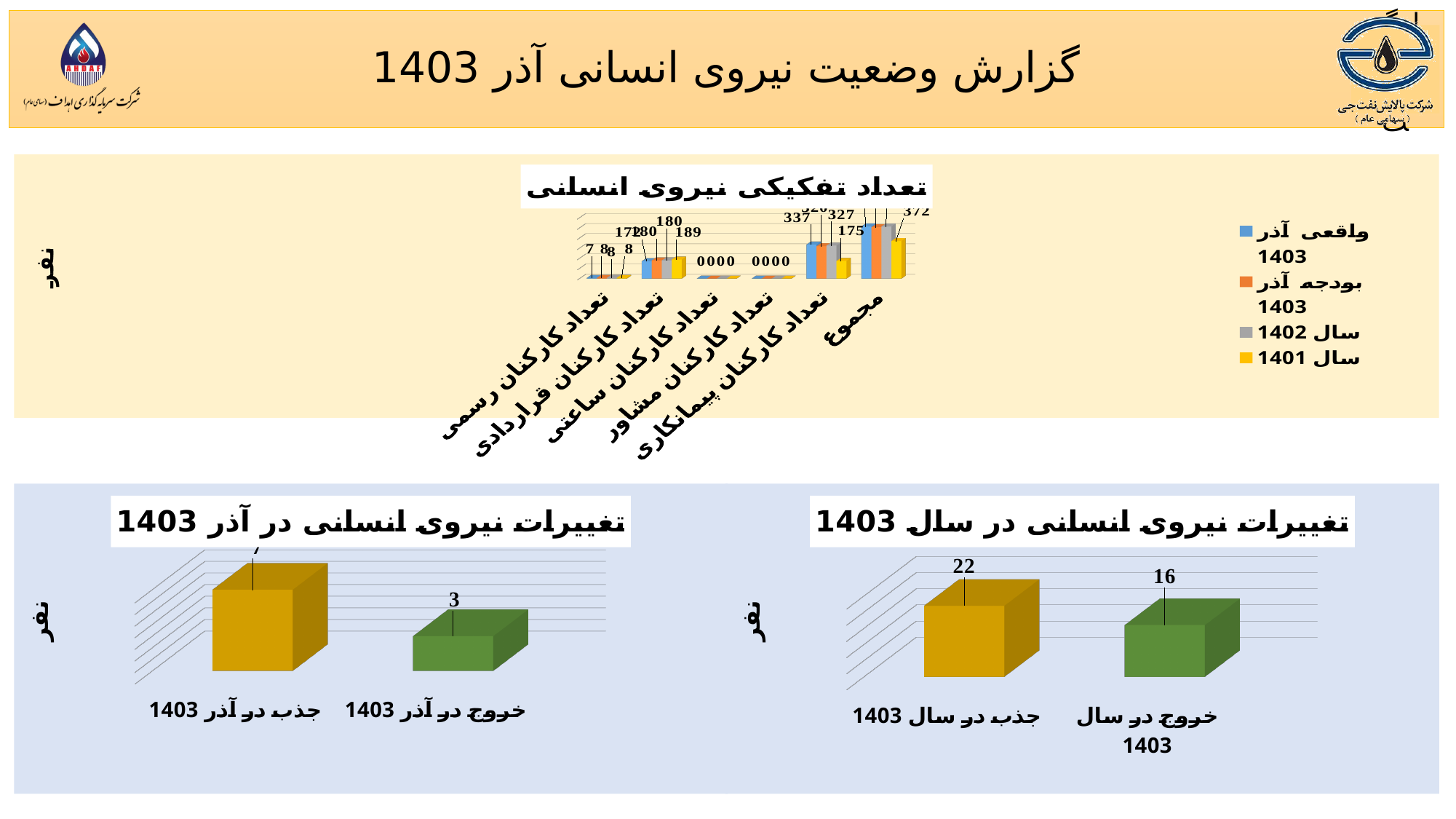
In the top chart titled 'تعداد تفکیکی نیروی انسانی', what is the value of 'سال 1401' for 'تعداد کارکنان قراردادی'? 189 In the top chart titled 'تعداد تفکیکی نیروی انسانی', how many categories are shown on the x axis? 6 What kind of chart is the bottom-right chart titled 'تغییرات نیروی انسانی در سال 1403'? bar chart In the top chart titled 'تعداد تفکیکی نیروی انسانی', what is the value of 'واقعی آذر 1403' for 'تعداد کارکنان پیمانکاری'? 337 In the chart titled 'تغییرات نیروی انسانی در سال 1403' (bottom right), what is the value for 'خروج در سال 1403'? 16 In the top chart titled 'تعداد تفکیکی نیروی انسانی', which legend entry is shown in yellow? سال 1401 In the top chart titled 'تعداد تفکیکی نیروی انسانی', how many series does the legend list? 4 In the chart titled 'تغییرات نیروی انسانی در سال 1403' (bottom right), what is the value for 'جذب در سال 1403'? 22 In the chart titled 'تغییرات نیروی انسانی در آذر 1403' (bottom left), how many bars are plotted? 2 In the chart titled 'تغییرات نیروی انسانی در آذر 1403' (bottom left), which category has the larger value, 'جذب در آذر 1403' or 'خروج در آذر 1403'? جذب در آذر 1403 In the chart titled 'تغییرات نیروی انسانی در سال 1403' (bottom right), what is the difference between 'جذب در سال 1403' and 'خروج در سال 1403'? 6 In the chart titled 'تغییرات نیروی انسانی در آذر 1403' (bottom left), what is the value for 'خروج در آذر 1403'? 3